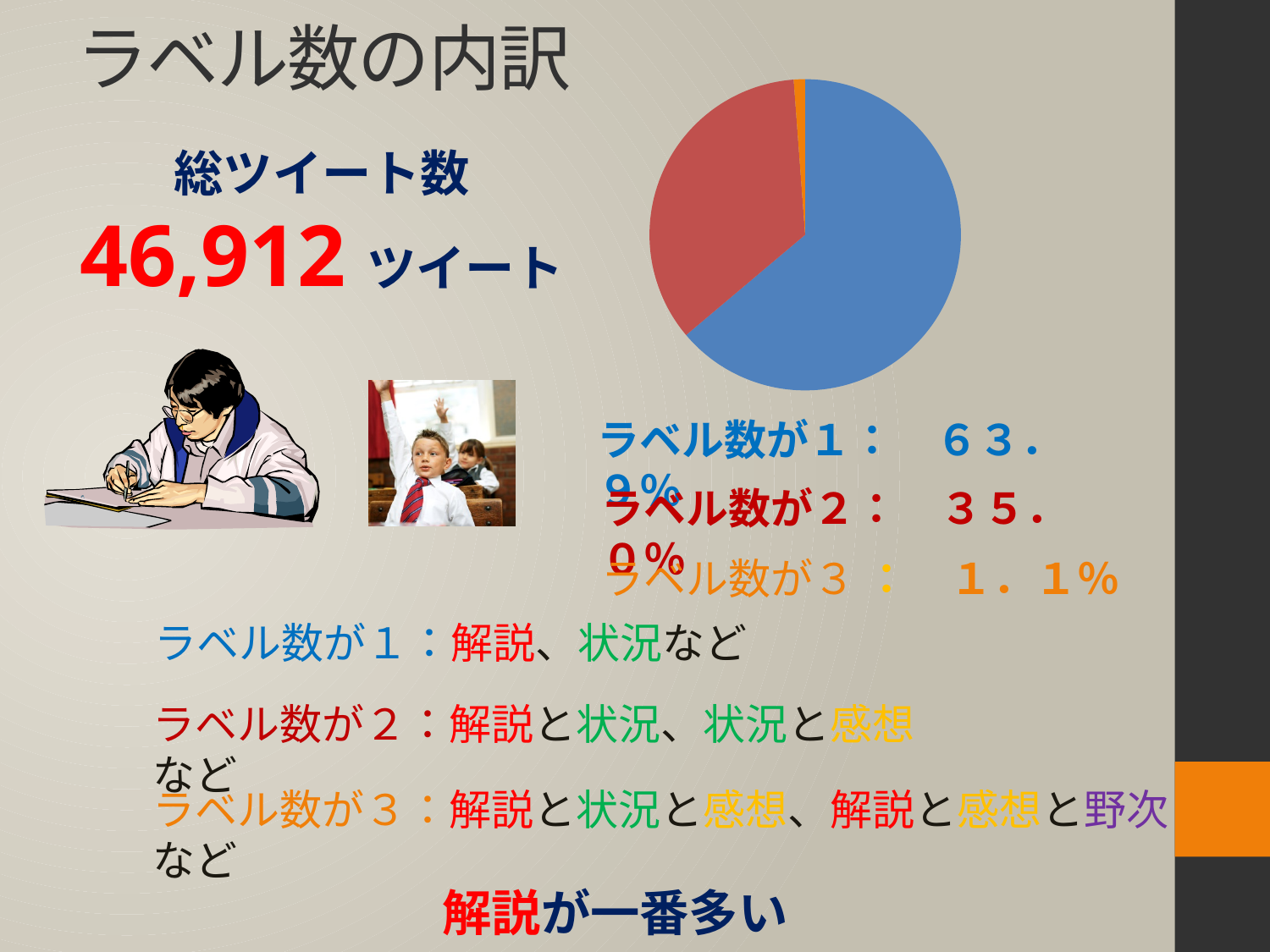
What kind of chart is shown on the slide? pie chart Which category has the largest slice of the pie? ラベル数が1 What is the total number of tweets stated on the slide? 46,912 What is the value shown for ラベル数が3? 1.1% What share of the pie does ラベル数が1 account for? 63.9% What colour is the slice for ラベル数が1 in the pie chart? blue What colour is the slice for ラベル数が3 in the pie chart? orange How many slices does the pie chart have? 3 What is the value shown for ラベル数が2? 35.0% What is the difference in percentage points between ラベル数が1 and ラベル数が2? 28.9 Which is larger, the share for ラベル数が2 or the share for ラベル数が3? ラベル数が2 Which category has the smallest slice of the pie? ラベル数が3